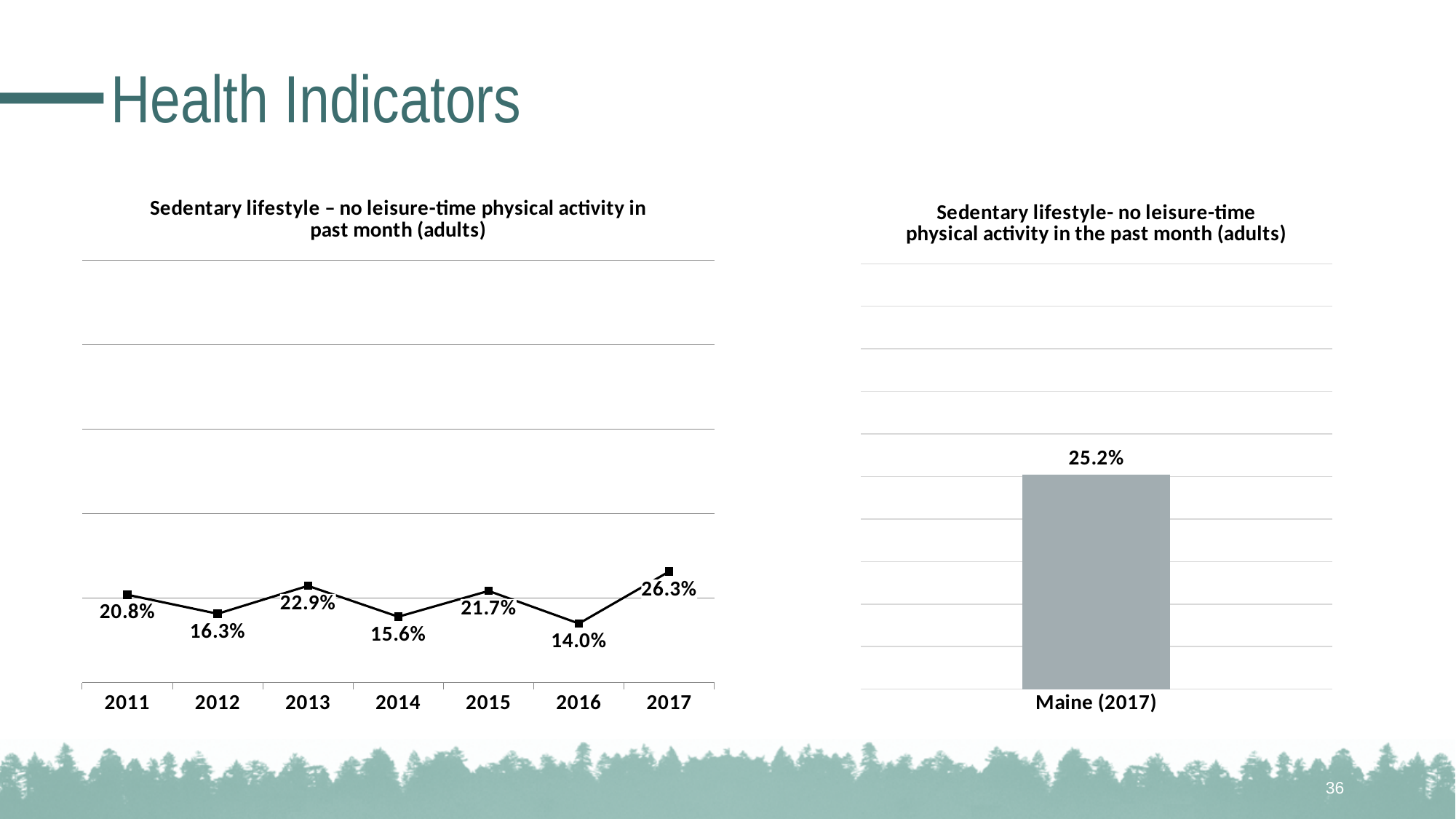
In the left chart, what is the value for 2016? 14.0% How many years are plotted in the left chart? 7 In the right chart, what is the value for Maine (2017)? 25.2% In the left chart, what is the value for 2011? 20.8% What kind of chart is the right chart? bar chart What kind of chart is the left chart? line chart Which is larger, the 2017 value in the left chart or the Maine (2017) value in the right chart? the 2017 value in the left chart In the left chart, which year has the lowest value? 2016 In the left chart, what is the value for 2017? 26.3% In the left chart, what is the difference between the values for 2017 and 2016? 12.3% In the left chart, which year has the highest value? 2017 In the left chart, which is larger, the value for 2013 or the value for 2015? 2013